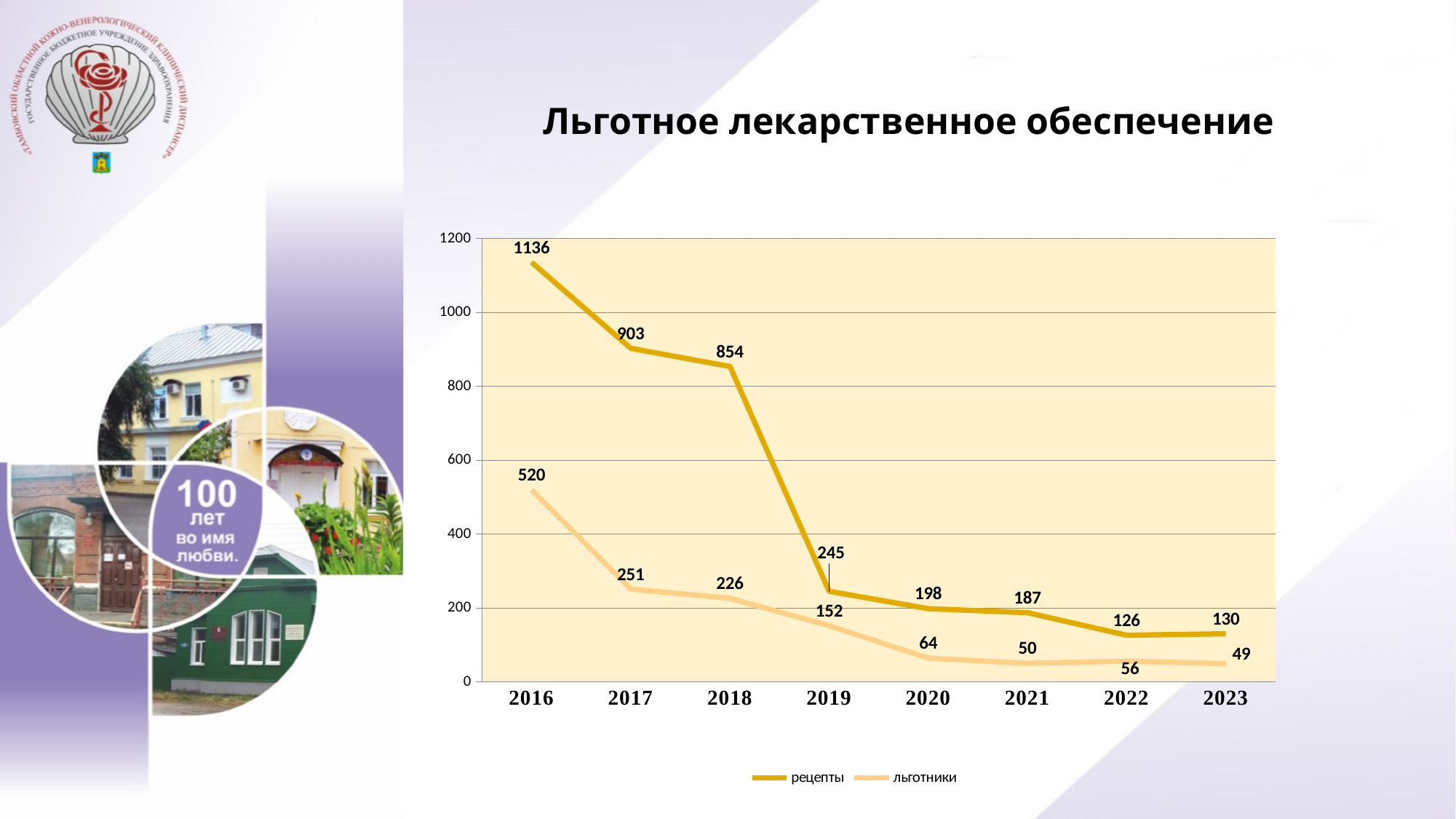
What type of chart is shown on the slide? line chart Which is larger: the льготники value in 2020 or in 2022? 2020 How many series does the legend list? 2 Do the рецепты values generally rise or fall from 2016 to 2023? fall What is the title of the chart? Льготное лекарственное обеспечение What is the value for льготники in 2019? 152 How many years are shown on the x axis? 8 In which year is the value for рецепты highest? 2016 What is the difference between the рецепты values for 2018 and 2019? 609 In which year is the value for льготники lowest? 2023 What is the value for рецепты in 2023? 130 What is the value for рецепты in 2016? 1136